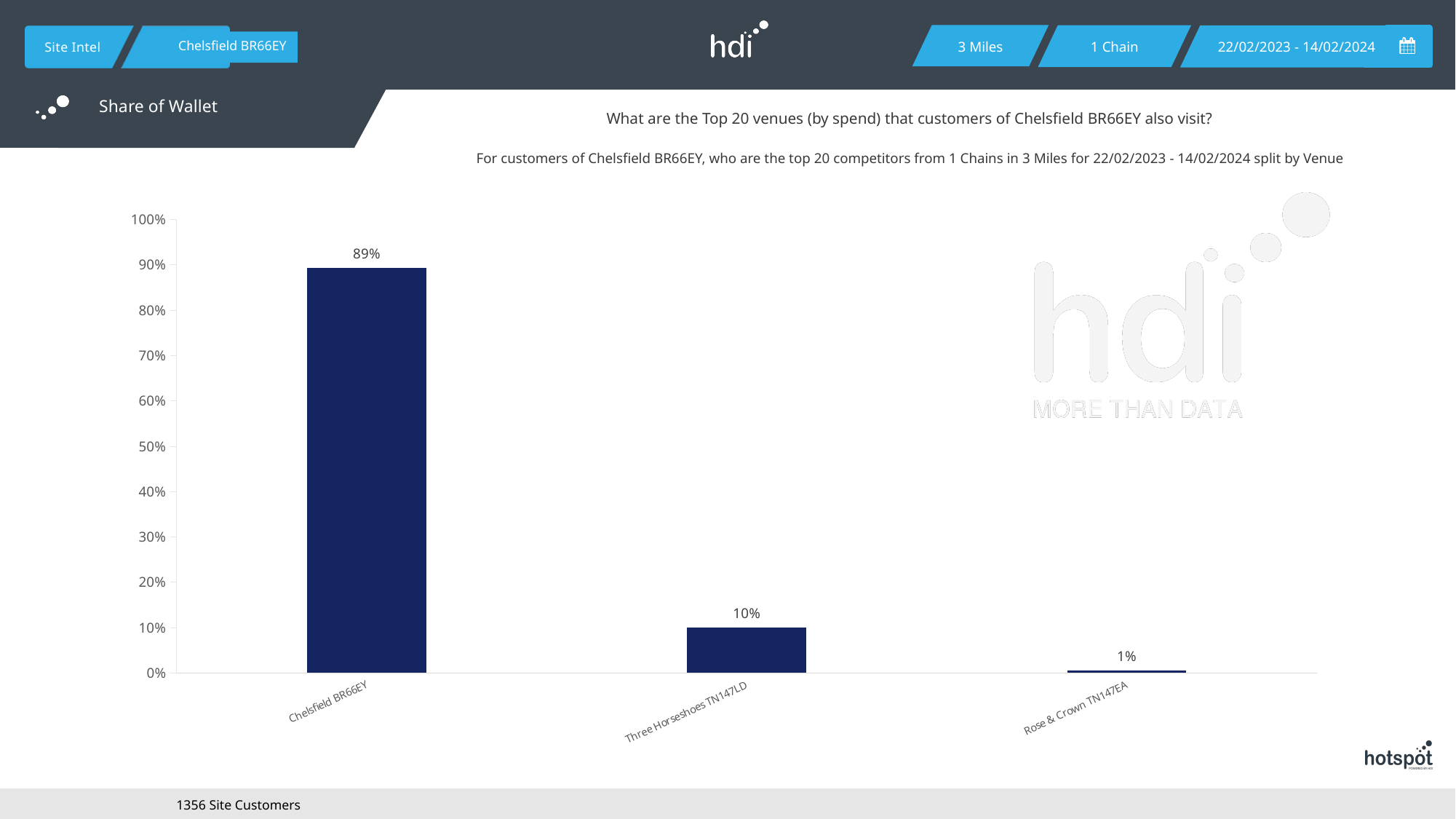
What is the value for Chelsfield BR66EY? 89% What is the value for Three Horseshoes TN147LD? 10% How many venues are shown on the chart? 3 Do the values rise or fall from left to right along the x axis? fall What is the difference between the values for Three Horseshoes TN147LD and Rose & Crown TN147EA? 9% Is the value for Chelsfield BR66EY greater or less than 80%? greater What is the difference between the values for Chelsfield BR66EY and Three Horseshoes TN147LD? 79% Which venue has the highest value? Chelsfield BR66EY Which is larger, the value for Three Horseshoes TN147LD or the value for Rose & Crown TN147EA? Three Horseshoes TN147LD What kind of chart is shown on the slide? bar chart Which venue has the lowest value? Rose & Crown TN147EA What is the value for Rose & Crown TN147EA? 1%